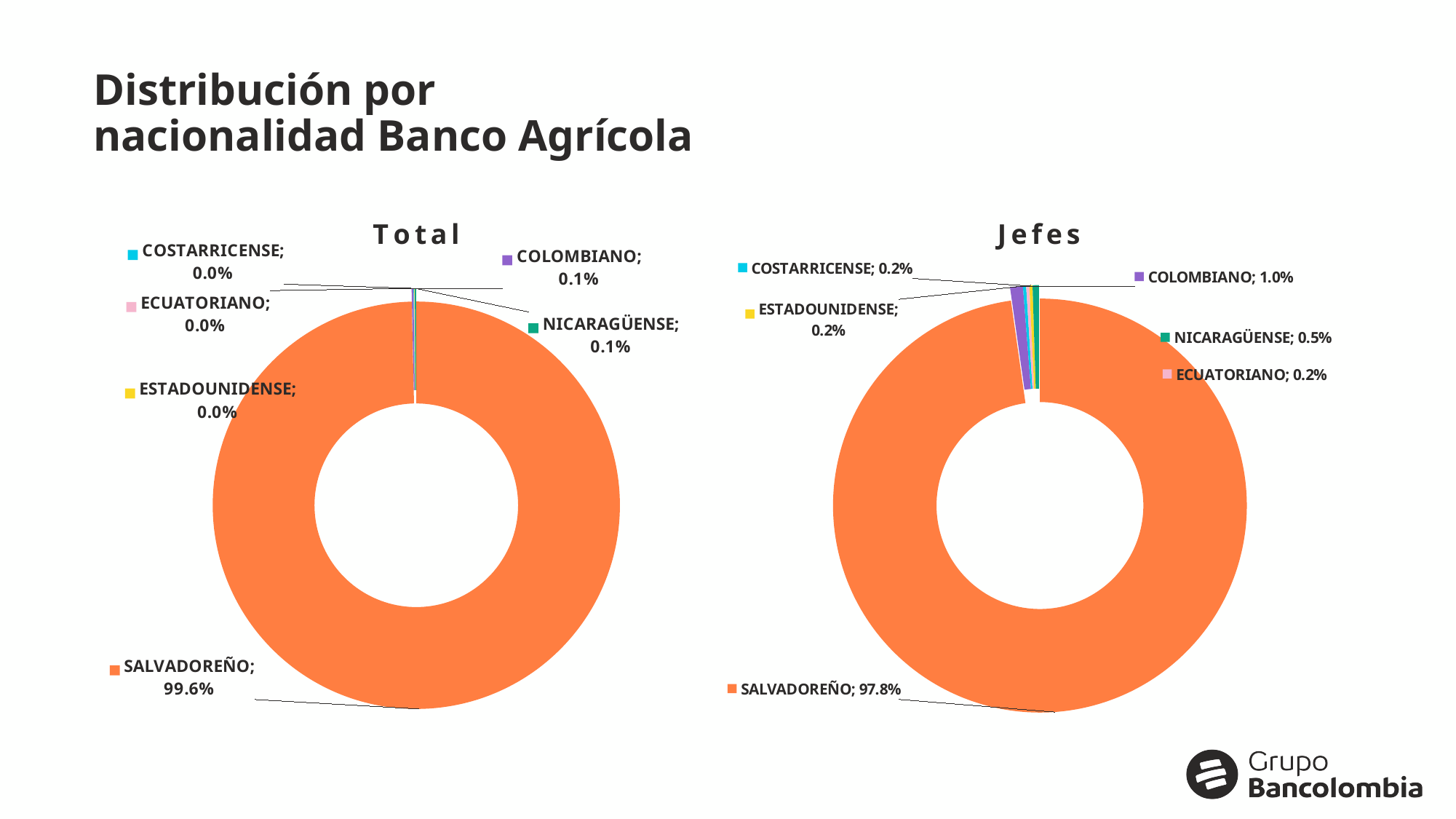
In the Jefes chart, what is the difference between the COLOMBIANO and NICARAGÜENSE shares? 0.5% In the Jefes chart, what share is shown for COLOMBIANO? 1.0% In the Jefes chart, what share is shown for NICARAGÜENSE? 0.5% In the Jefes chart, which nationality has the second-largest share? COLOMBIANO How many nationality categories does the Total chart show? 6 In the Total chart, what share is shown for COLOMBIANO? 0.1% In the Jefes chart, what share is shown for SALVADOREÑO? 97.8% What kind of chart is the Jefes chart? Pie (donut) chart In the Jefes chart, which nationality has the largest share? SALVADOREÑO What is the difference between the SALVADOREÑO share in the Total chart and in the Jefes chart? 1.8% In the Jefes chart, which is larger, the share for NICARAGÜENSE or the share for ECUATORIANO? NICARAGÜENSE In the Total chart, what share is shown for SALVADOREÑO? 99.6%